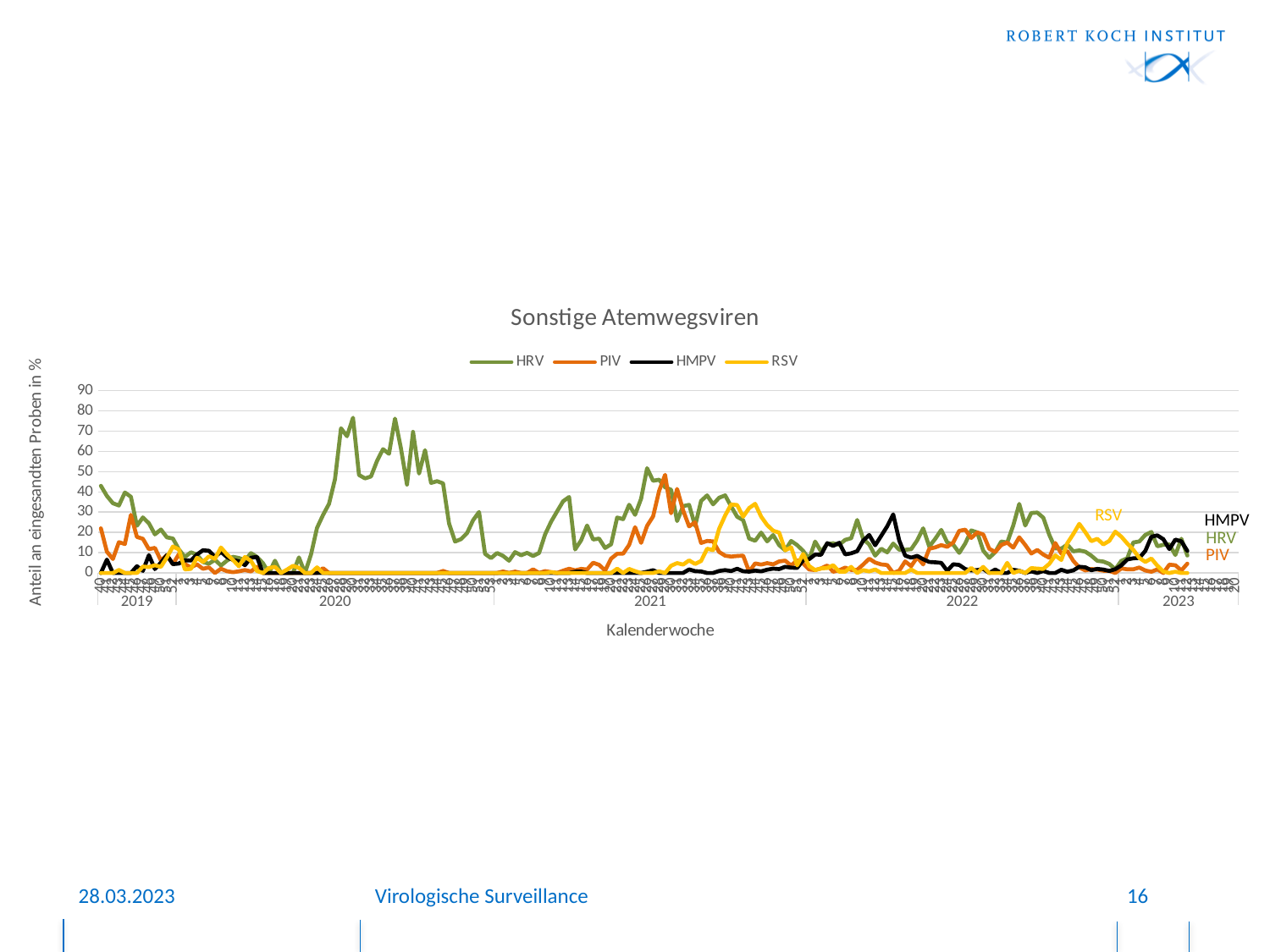
Is the highest value reached by RSV on the chart greater or less than 50? less What is the title of the chart? Sonstige Atemwegsviren Which series reaches higher values during 2020, HRV or PIV? HRV Is the highest value reached by HMPV on the chart greater or less than 40? less What kind of chart is shown on the slide? line chart Which series reaches the highest value anywhere on the chart? HRV Is the highest value reached by PIV in 2021 greater or less than 40? greater How many year labels are shown along the x axis of the chart? 5 Which series reaches a higher peak value on the chart, HRV or RSV? HRV How many series does the legend of the chart list? 4 What is the label of the vertical axis of the chart? Anteil an eingesandten Proben in %